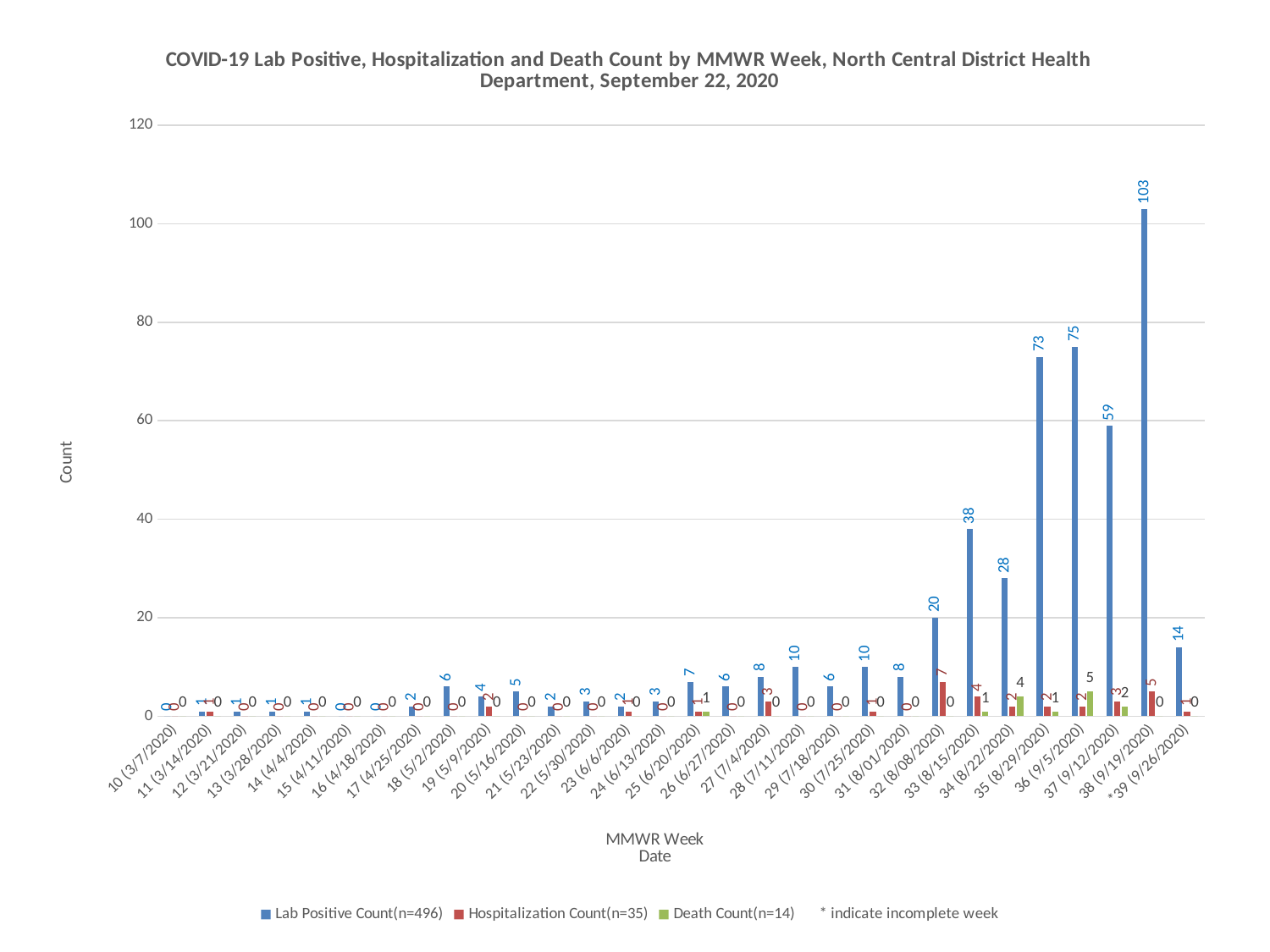
According to the legend note, what does the asterisk (*) indicate? Incomplete week What is the difference between the Lab Positive Count for week 36 (9/5/2020) and week 35 (8/29/2020)? 2 How many MMWR weeks are shown on the x axis? 30 What is the Hospitalization Count for MMWR week 32 (8/08/2020)? 7 What is the Lab Positive Count for MMWR week 32 (8/08/2020)? 20 What kind of chart is shown on the slide? Bar chart Is the Lab Positive Count for week 35 (8/29/2020) greater or less than 60? greater What is the Death Count for MMWR week 36 (9/5/2020)? 5 Which MMWR week has the highest Lab Positive Count? 38 (9/19/2020) How many series does the legend list? 3 What is the Lab Positive Count for MMWR week 38 (9/19/2020)? 103 Which week has a larger Lab Positive Count, 33 (8/15/2020) or 34 (8/22/2020)? 33 (8/15/2020)